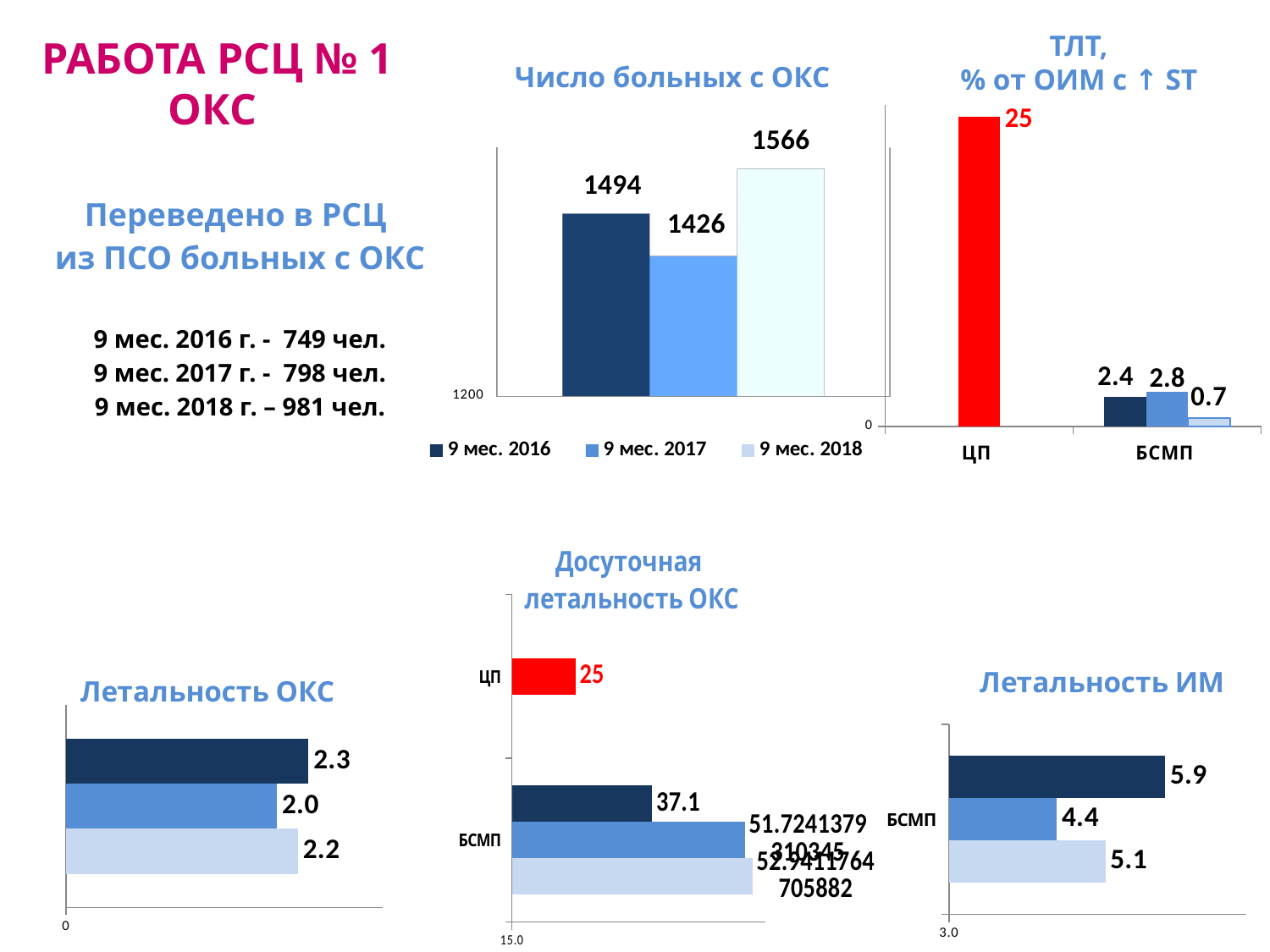
In the chart titled 'Число больных с ОКС', which period has the highest value? 9 мес. 2018 In the chart titled 'Число больных с ОКС', what is the value for 9 мес. 2018? 1566 In the chart titled 'Число больных с ОКС', which period has the lowest value? 9 мес. 2017 In the chart titled 'Число больных с ОКС', what is the difference between the values for 9 мес. 2018 and 9 мес. 2016? 72 In the chart titled 'Число больных с ОКС', what is the value for 9 мес. 2017? 1426 In the chart titled 'Летальность ОКС', what is the value of the dark blue bar? 2.3 How many series does the legend of the chart titled 'Число больных с ОКС' list? 3 What type of chart is the chart titled 'Досуточная летальность ОКС'? bar chart In the chart titled 'ТЛТ, % от ОИМ с ↑ ST', what is the lowest value shown for БСМП? 0.7 In the chart titled 'Летальность ИМ', what is the difference between the largest and smallest values? 1.5 In the chart titled 'ТЛТ, % от ОИМ с ↑ ST', what is the value for ЦП? 25 In the chart titled 'Летальность ИМ', which is larger: the dark blue bar or the light blue bar? the dark blue bar